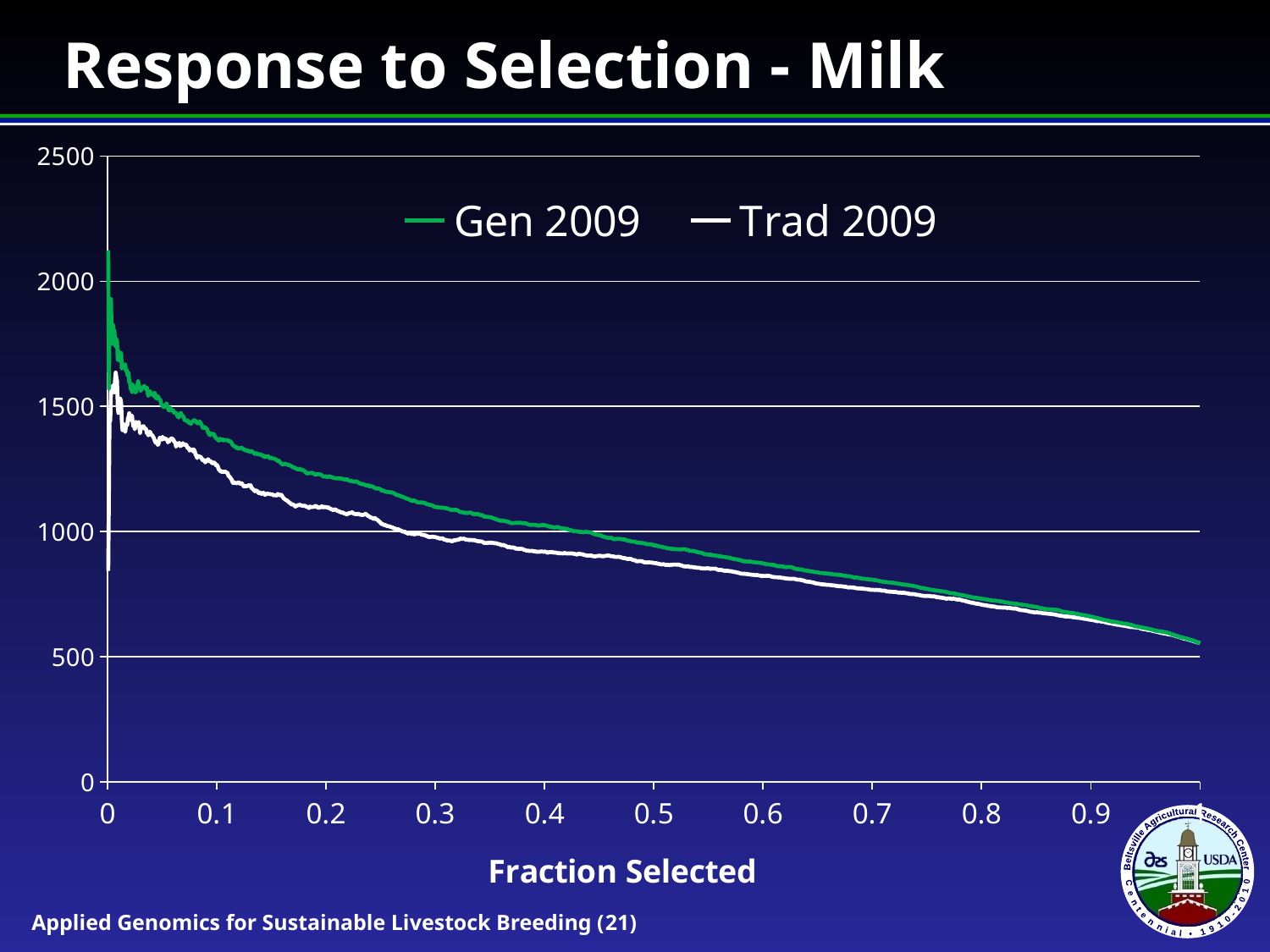
Is the value for Gen 2009 at a fraction selected of 0.9 greater or less than 500? greater What kind of chart is shown on the slide? Line chart At a fraction selected of 0.2, which series has the higher value, Gen 2009 or Trad 2009? Gen 2009 Do the values for Trad 2009 rise or fall as Fraction Selected increases? Fall Is the value for Gen 2009 at a fraction selected of 0.2 greater or less than 1000? greater Is the value for Gen 2009 at a fraction selected of 0.5 greater or less than 1000? less What is the title of the chart? Response to Selection - Milk Do the values for Gen 2009 rise or fall as Fraction Selected increases? Fall What is the label of the x axis? Fraction Selected How many series does the legend list? 2